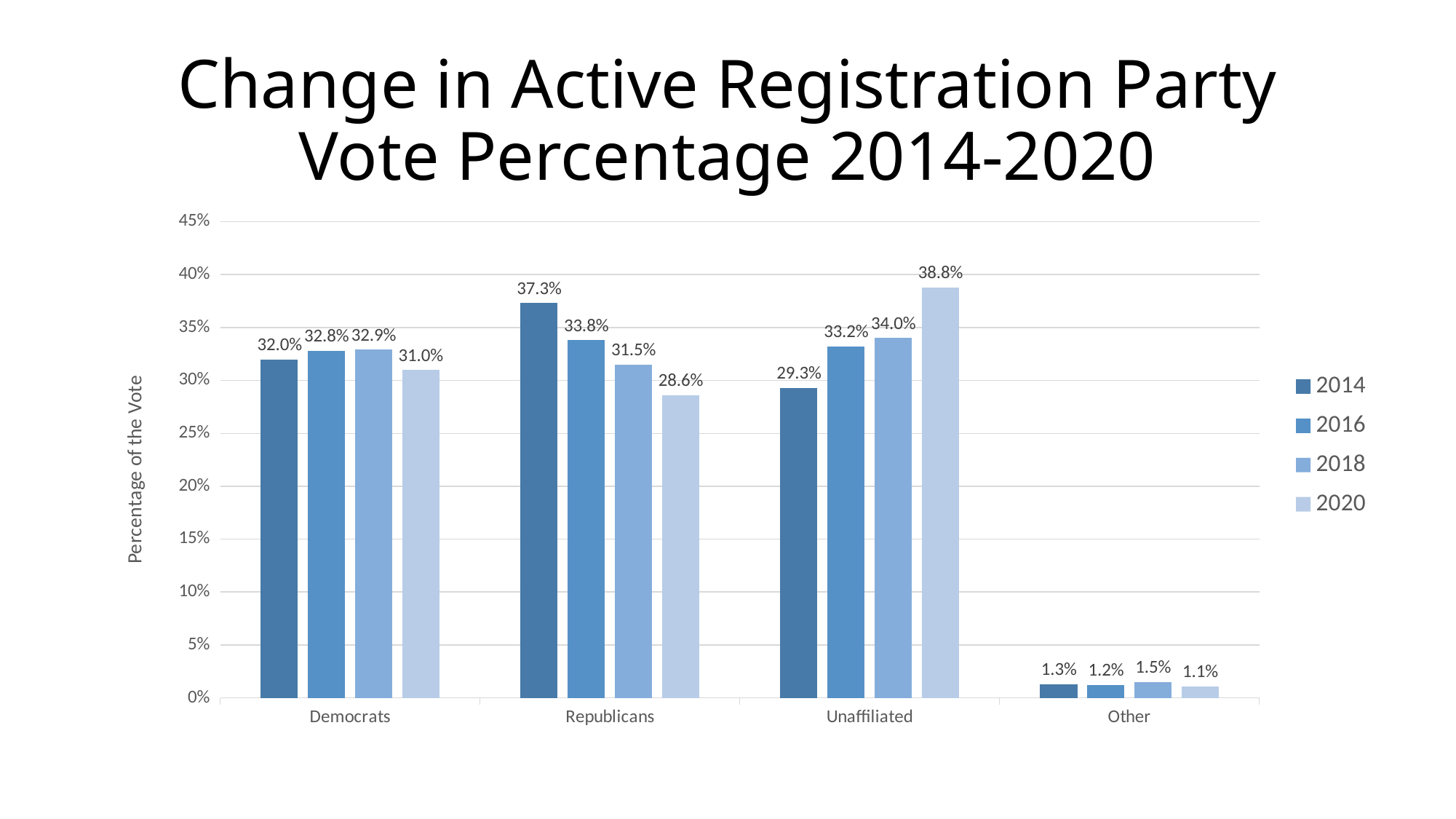
What is the value for Republicans in 2014? 37.3% Which category has the highest value in 2020? Unaffiliated What is the value for Unaffiliated in 2020? 38.8% What kind of chart is shown on the slide? Bar chart How many series does the legend list? 4 What is the difference between the Republicans value in 2014 and in 2020? 8.7% Do the Republicans values rise or fall from 2014 to 2020? Fall Which category has the lowest value in 2014? Other What is the value for Other in 2016? 1.2% Which is larger, the Democrats value in 2016 or the Unaffiliated value in 2016? Unaffiliated value in 2016 How many categories are shown on the x axis? 4 What is the value for Democrats in 2018? 32.9%